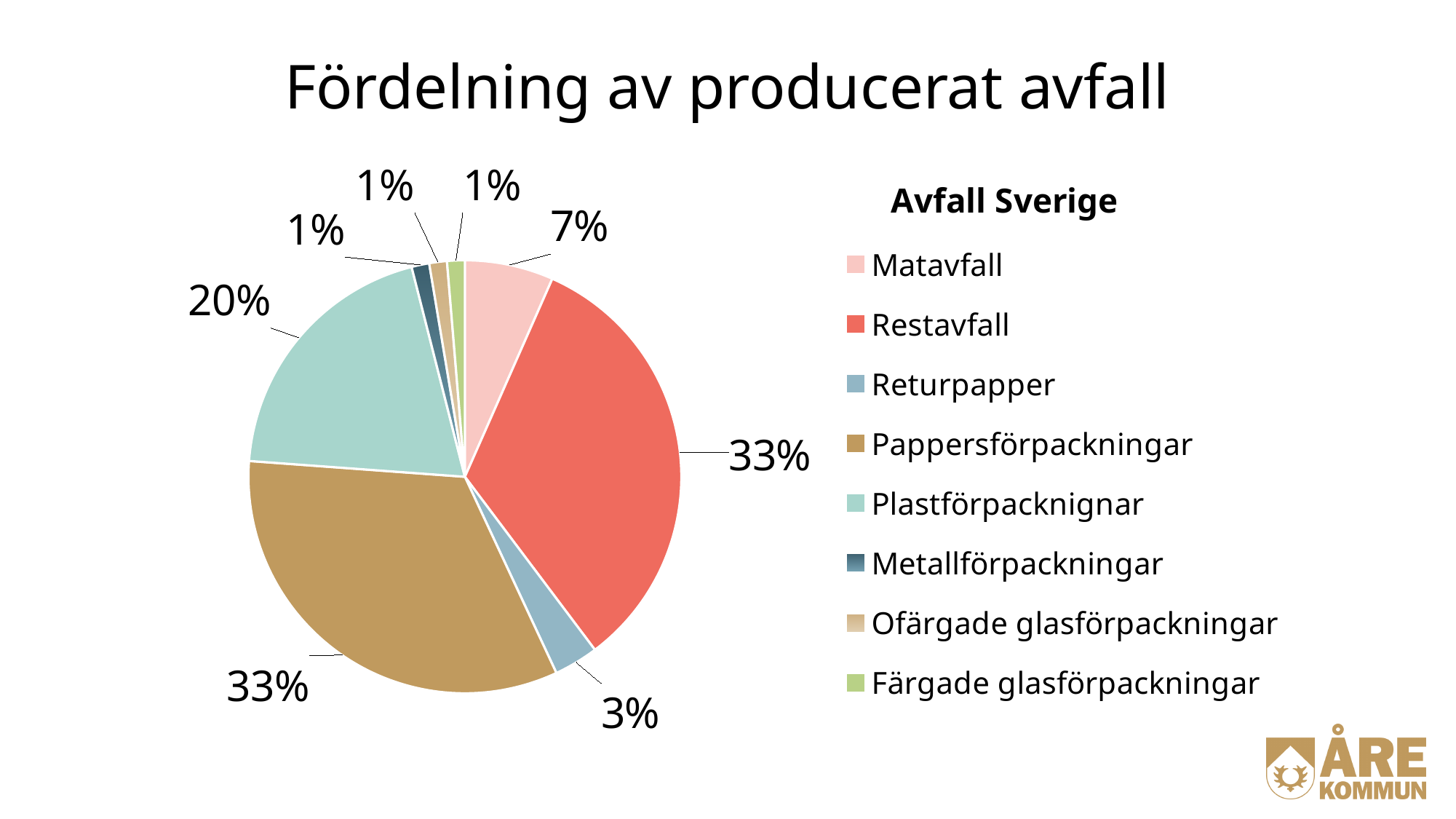
What percentage is shown for Restavfall? 33% What share does Metallförpackningar have? 1% What kind of chart is shown on the slide? Pie chart What is the title of the legend? Avfall Sverige What share of the pie does Matavfall represent? 7% What is the difference in percentage points between Restavfall and Returpapper? 30 What share does Returpapper have in the pie chart? 3% What percentage is shown for Plastförpackningar? 20% Which has a larger share, Plastförpackningar or Matavfall? Plastförpackningar How many categories does the legend list? 8 What is the difference in percentage points between Plastförpackningar and Matavfall? 13 Which has a larger share, Returpapper or Matavfall? Matavfall